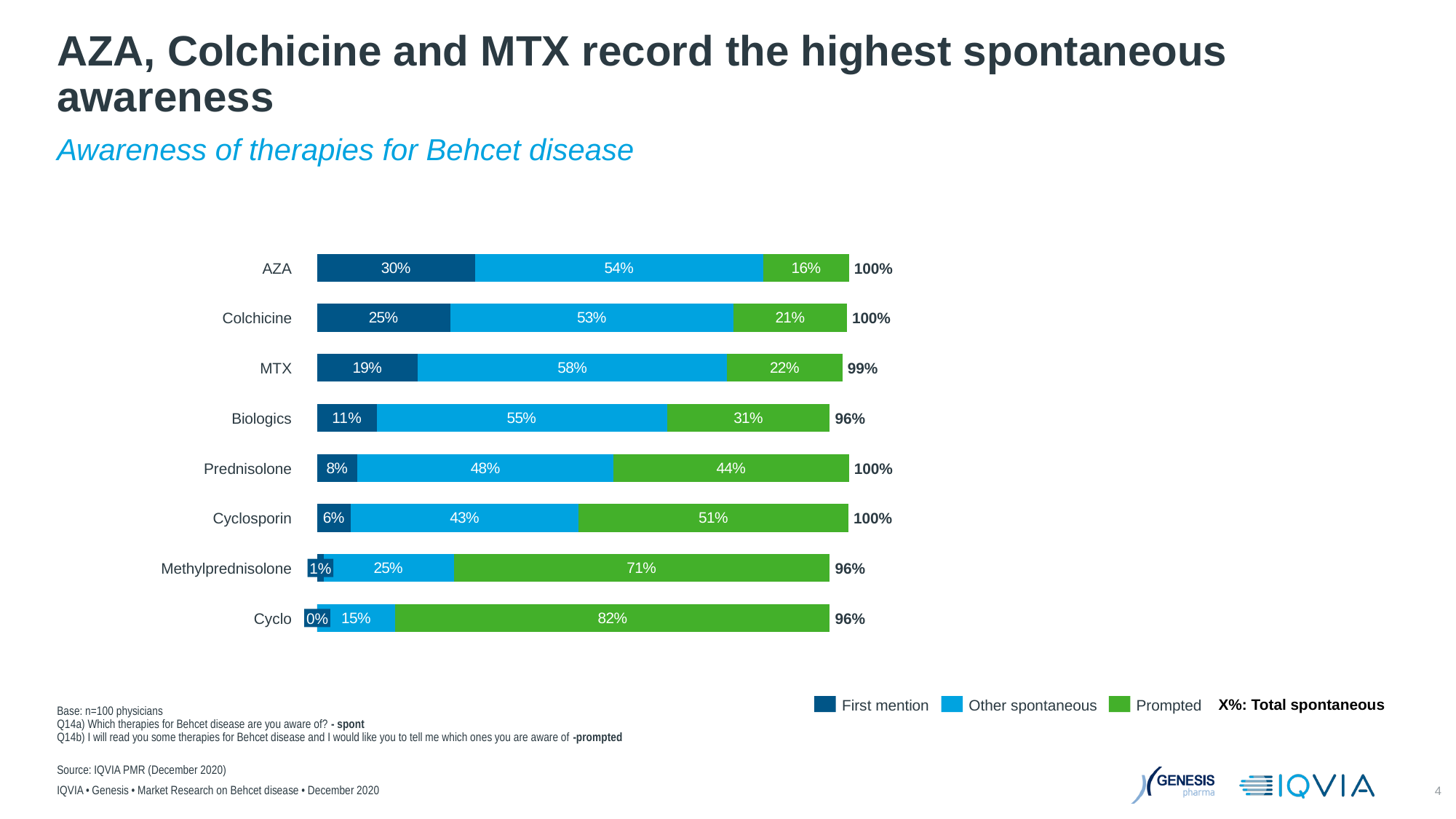
How many series does the legend list? 3 What is the total shown at the end of the bar for Biologics? 96% What is the Prompted value for Cyclo? 82% Which is larger, the Other spontaneous value for Biologics or for Colchicine? Biologics Which therapy has the lowest Prompted value? AZA Which therapy has the highest First mention value? AZA What is the Other spontaneous value for MTX? 58% How many therapies are shown in the chart? 8 What is the First mention value for AZA? 30% What is the subtitle of the chart? Awareness of therapies for Behcet disease What is the difference between the Prompted values for Cyclosporin and Prednisolone? 7% What kind of chart is shown on the slide? Stacked bar chart